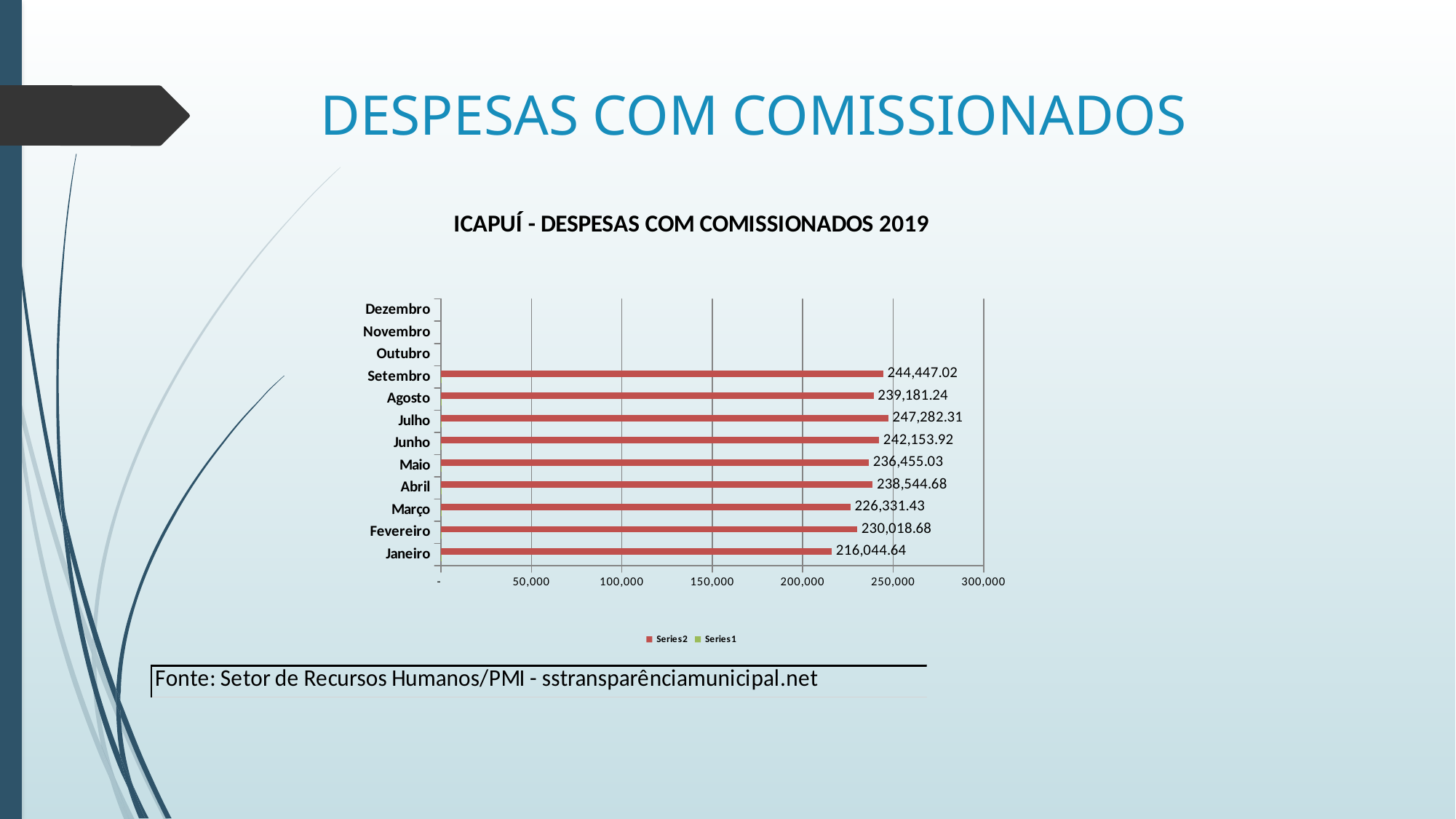
What is the value for Setembro? 244,447.02 Is the value for Janeiro greater or less than 250,000? less What kind of chart is shown? bar chart What is the difference between the values for Setembro and Agosto? 5,265.78 What is the value for Janeiro? 216,044.64 Which month has the lowest value? Janeiro What is the difference between the values for Julho and Janeiro? 31,237.67 How many series does the legend list? 2 What is the value for Julho? 247,282.31 Which month has the highest value? Julho Which is larger, the value for Junho or the value for Maio? Junho How many month categories are listed on the vertical axis? 12